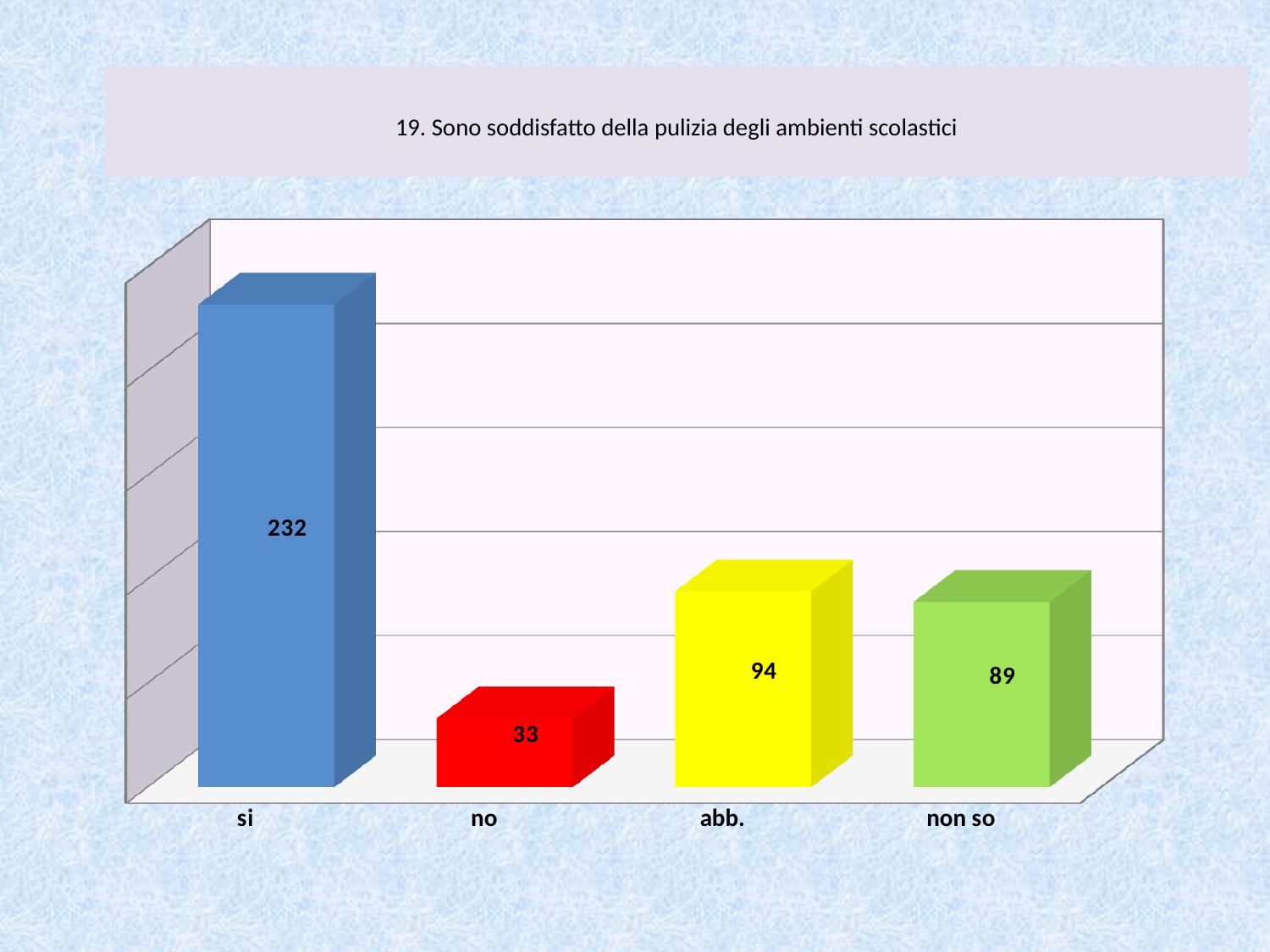
What is the difference between the values for "si" and "no"? 199 Which category has the lowest value? no What is the title of the chart? 19. Sono soddisfatto della pulizia degli ambienti scolastici What is the difference between the values for "abb." and "non so"? 5 What kind of chart is shown on the slide? bar chart Which category has the highest value? si What is the value for "non so"? 89 How many categories are shown on the x axis? 4 What is the value for "abb."? 94 What is the value for "no"? 33 What is the value for "si"? 232 Which is larger, the value for "abb." or the value for "no"? abb.